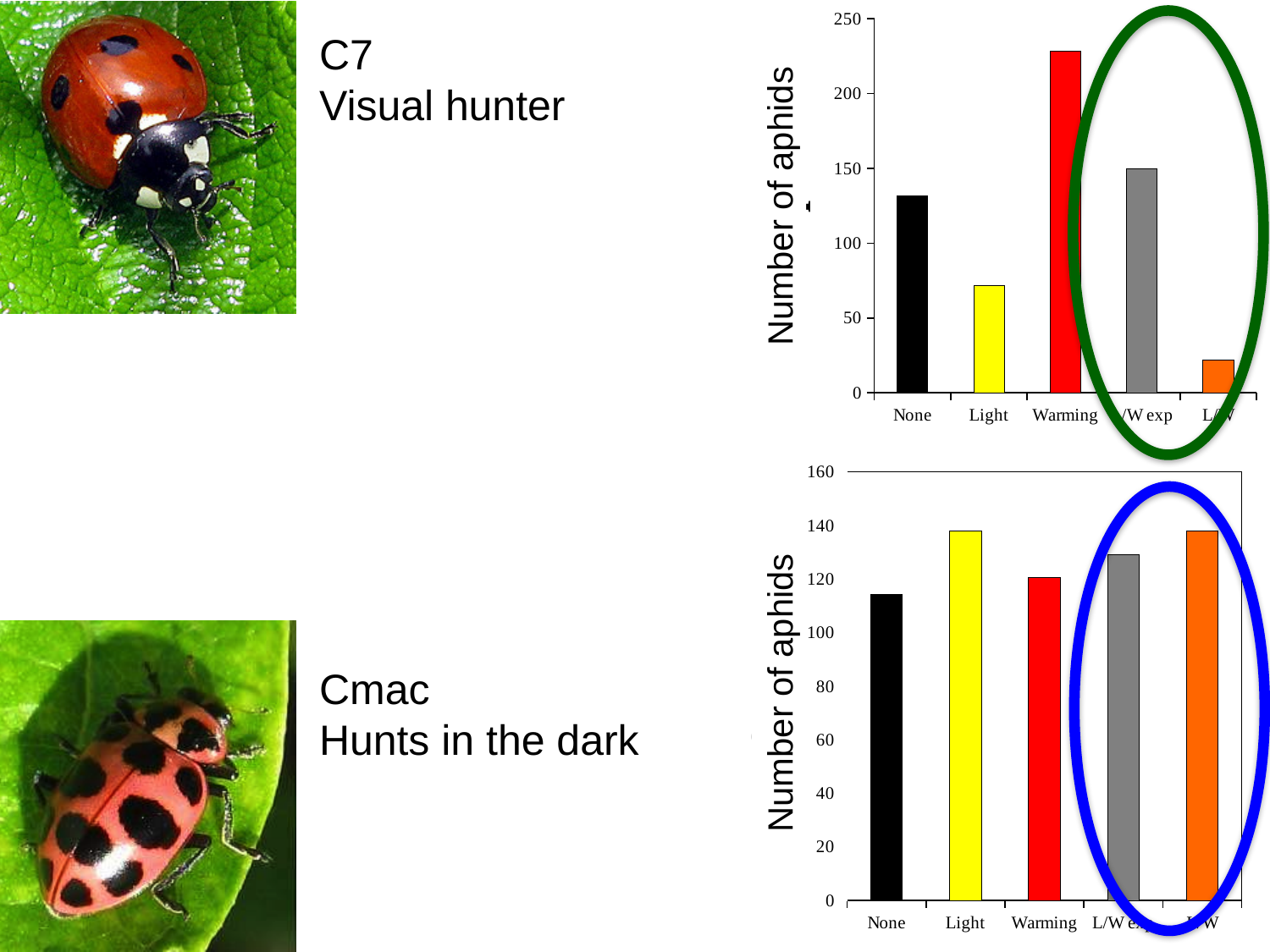
In the bottom chart, which is larger, the value for Light or the value for None? Light In the top chart, what colour is the bar for Warming? red How many categories are shown on the x axis of the top chart? 5 What is the y-axis title of the bottom chart? Number of aphids In the top chart, which category has the highest number of aphids? Warming In the top chart, which is larger, the value for None or the value for Light? None In the top chart, which category has the lowest number of aphids? L/W In the top chart, is the value for Warming greater or less than 200? greater In the top chart, is the value for Light greater or less than 100? less In the bottom chart, is the value for None greater or less than 100? greater What kind of chart is the top chart on the slide? bar chart